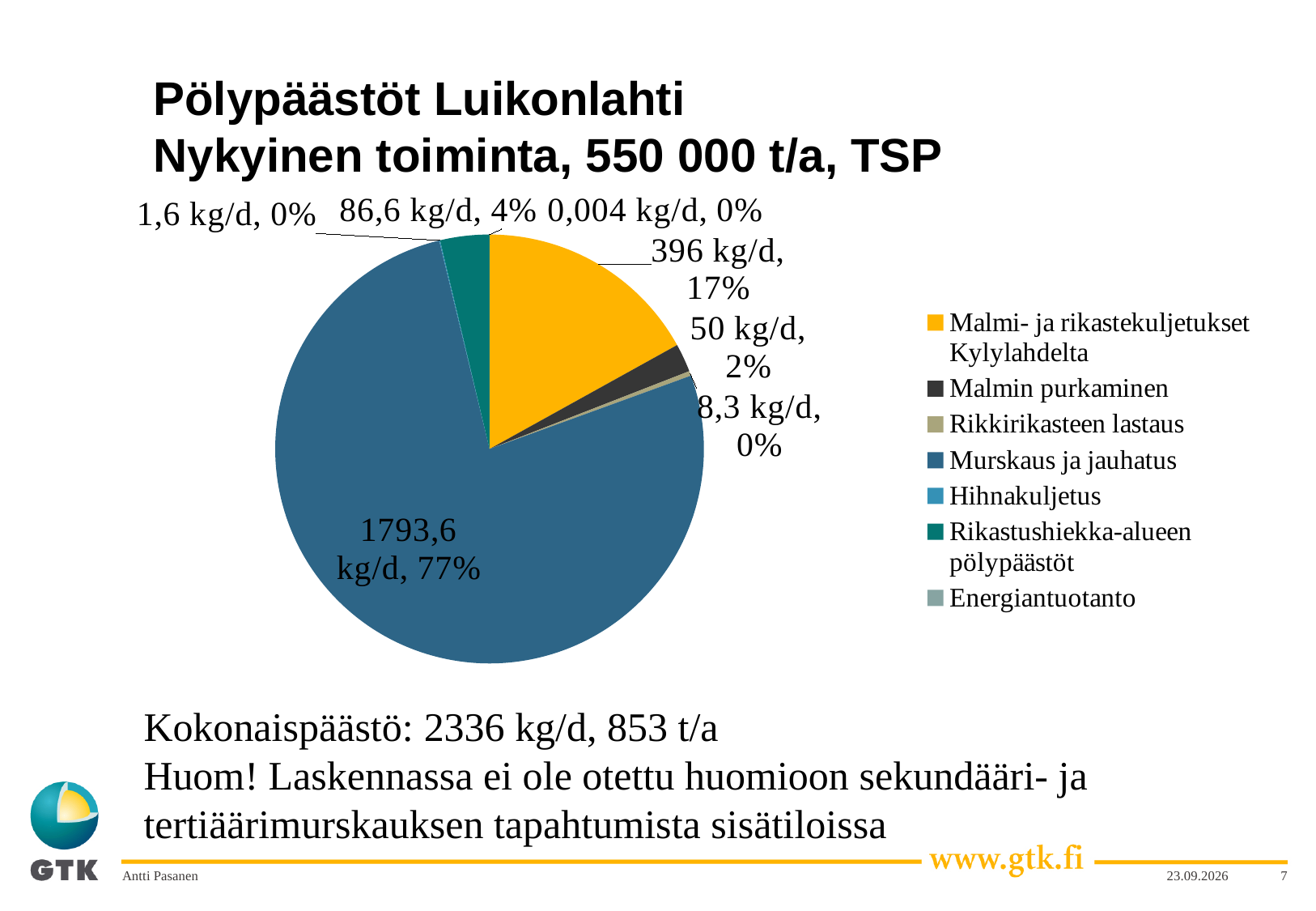
What is the value for Rikastushiekka-alueen pölypäästöt? 86,6 kg/d What is the value for Malmi- ja rikastekuljetukset Kylylahdelta? 396 kg/d What is the difference between the values for Malmi- ja rikastekuljetukset Kylylahdelta and Malmin purkaminen? 346 kg/d What share of the pie does Malmi- ja rikastekuljetukset Kylylahdelta represent? 17% How many series does the legend list? 7 What is the value for Murskaus ja jauhatus? 1793,6 kg/d Which is larger, the value for Rikastushiekka-alueen pölypäästöt or the value for Malmin purkaminen? Rikastushiekka-alueen pölypäästöt What share of the pie does Murskaus ja jauhatus represent? 77% Which category has the largest slice of the pie? Murskaus ja jauhatus What kind of chart is shown on the slide? pie chart What is the value for Malmin purkaminen? 50 kg/d Which category has the smallest slice of the pie? Energiantuotanto